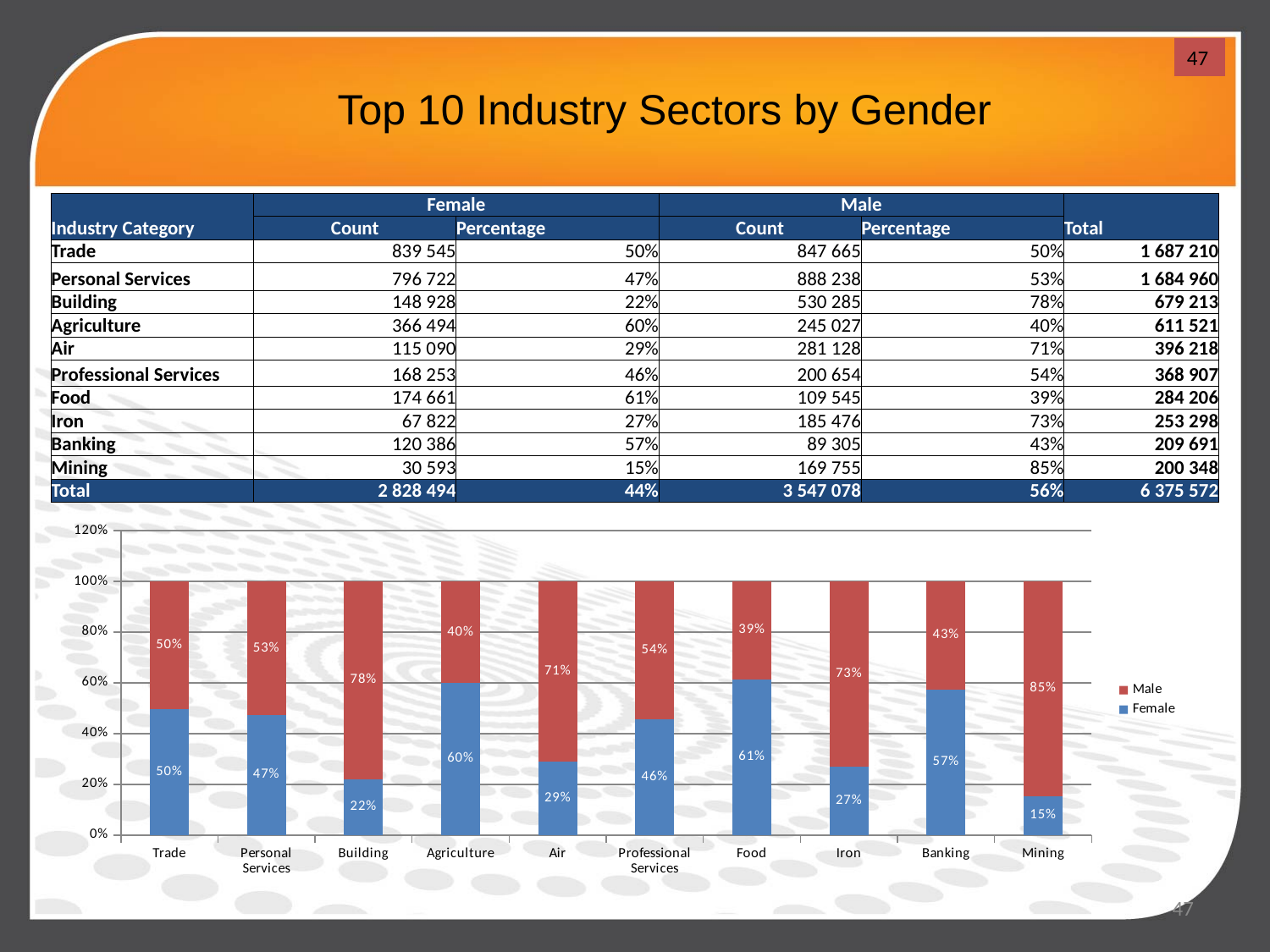
Which industry category has the lowest Female percentage in the chart? Mining Which colour represents the Male series in the chart? red Which industry category has the highest Male percentage in the chart? Mining What is the Male percentage for Mining in the chart? 85% How many industry categories are plotted on the x axis of the chart? 10 How many series does the chart legend list? 2 What kind of chart is shown on the slide? stacked bar chart What is the Female percentage for Building in the chart? 22% What is the Female percentage for Agriculture in the chart? 60% Which industry category has the highest Female percentage in the chart? Food Which is larger in the chart, the Female percentage for Banking or the Female percentage for Air? Banking What is the difference between the Male and Female percentages for Iron in the chart? 46%